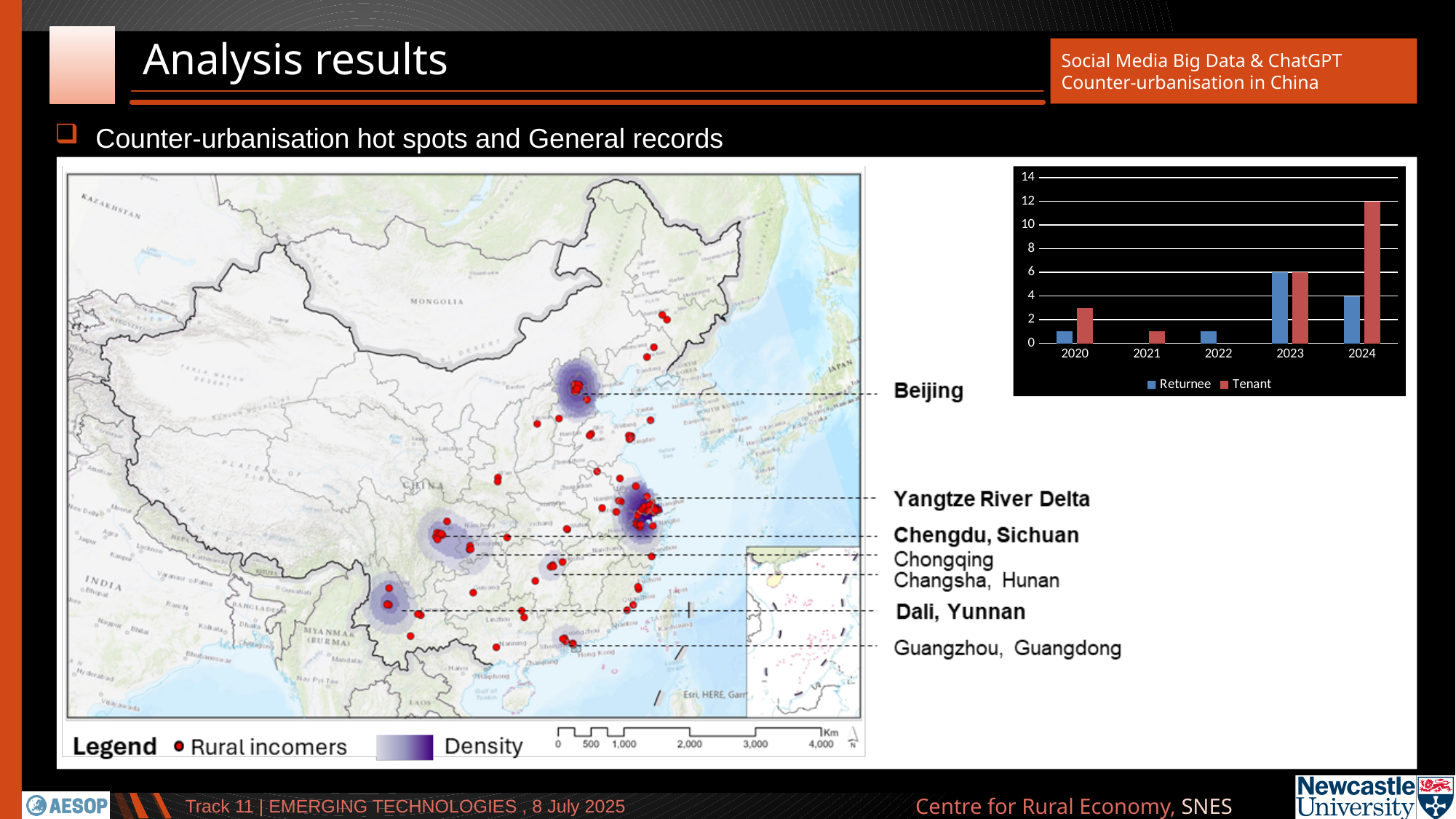
In the bar chart on the right, which is larger in 2024, Returnee or Tenant? Tenant In the bar chart on the right, how many series does the legend list? 2 In the bar chart on the right, how many years are shown on the x axis? 5 In the bar chart on the right, in which year is the Tenant value highest? 2024 In the bar chart on the right, what is the Tenant value for 2024? 12 In the bar chart on the right, what is the difference between the Tenant and Returnee values in 2024? 8 In the bar chart on the right, what is the Returnee value for 2023? 6 In the bar chart on the right, what is the Returnee value for 2024? 4 In the bar chart on the right, in which year is the Returnee value highest? 2023 In the bar chart on the right, what are the two legend entries? Returnee and Tenant In the bar chart on the right, what kind of chart is it? bar chart In the bar chart on the right, is the Tenant value for 2020 greater or less than 2? greater